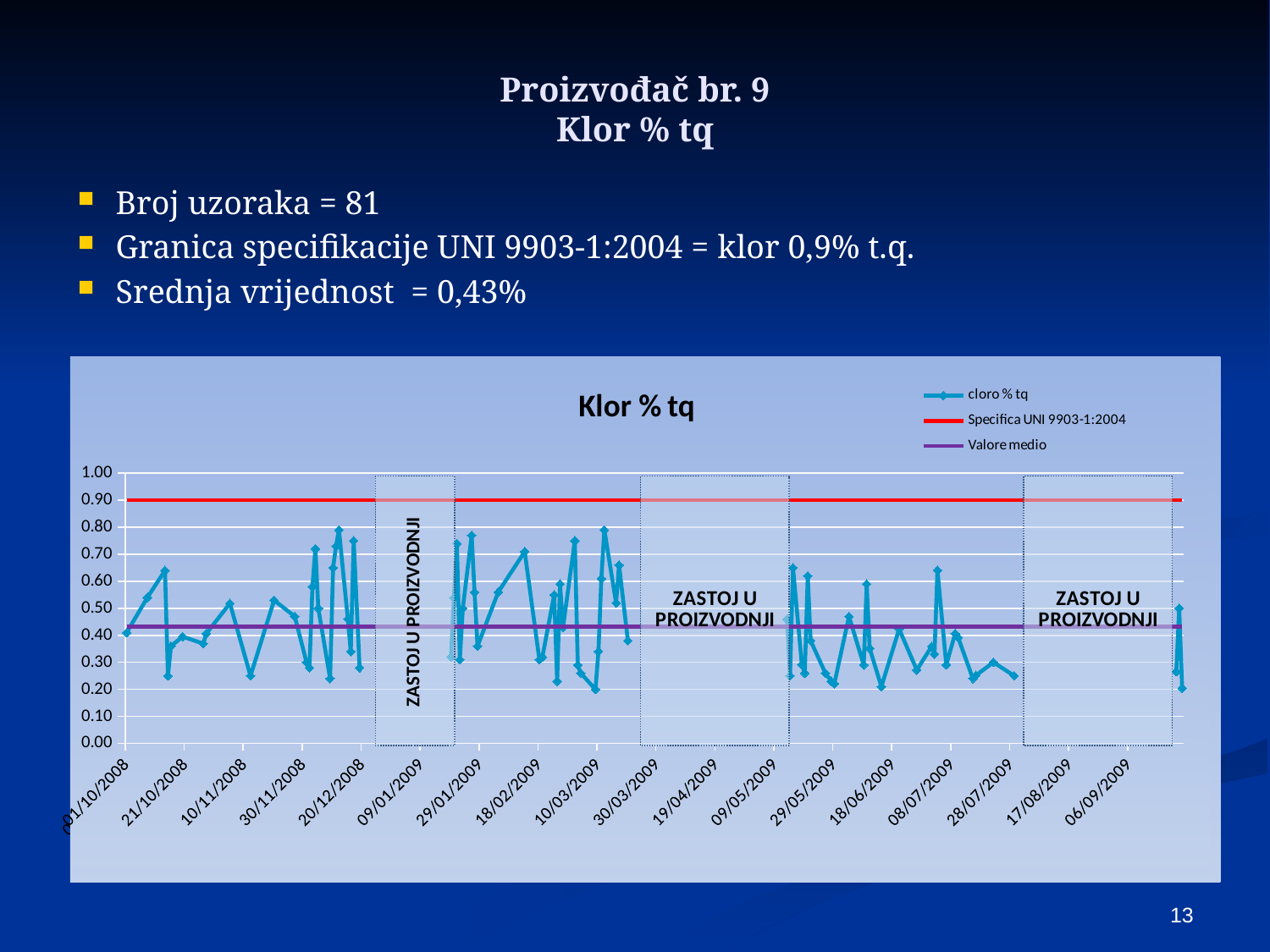
At what value does the Specifica UNI 9903-1:2004 line sit on the y axis? 0.90 Is the lowest cloro % tq value greater or less than 0.30? less Is the Valore medio line greater or less than 0.50? less What is the title of the chart? Klor % tq Is the Specifica UNI 9903-1:2004 line greater or less than 0.80? greater Which is higher, the Specifica UNI 9903-1:2004 line or the Valore medio line? Specifica UNI 9903-1:2004 How many date labels are shown on the x axis? 18 What is the maximum value shown on the y axis? 1.00 How many shaded 'ZASTOJ U PROIZVODNJI' regions are marked on the chart? 3 What kind of chart is shown on the slide? line chart How many series does the chart legend list? 3